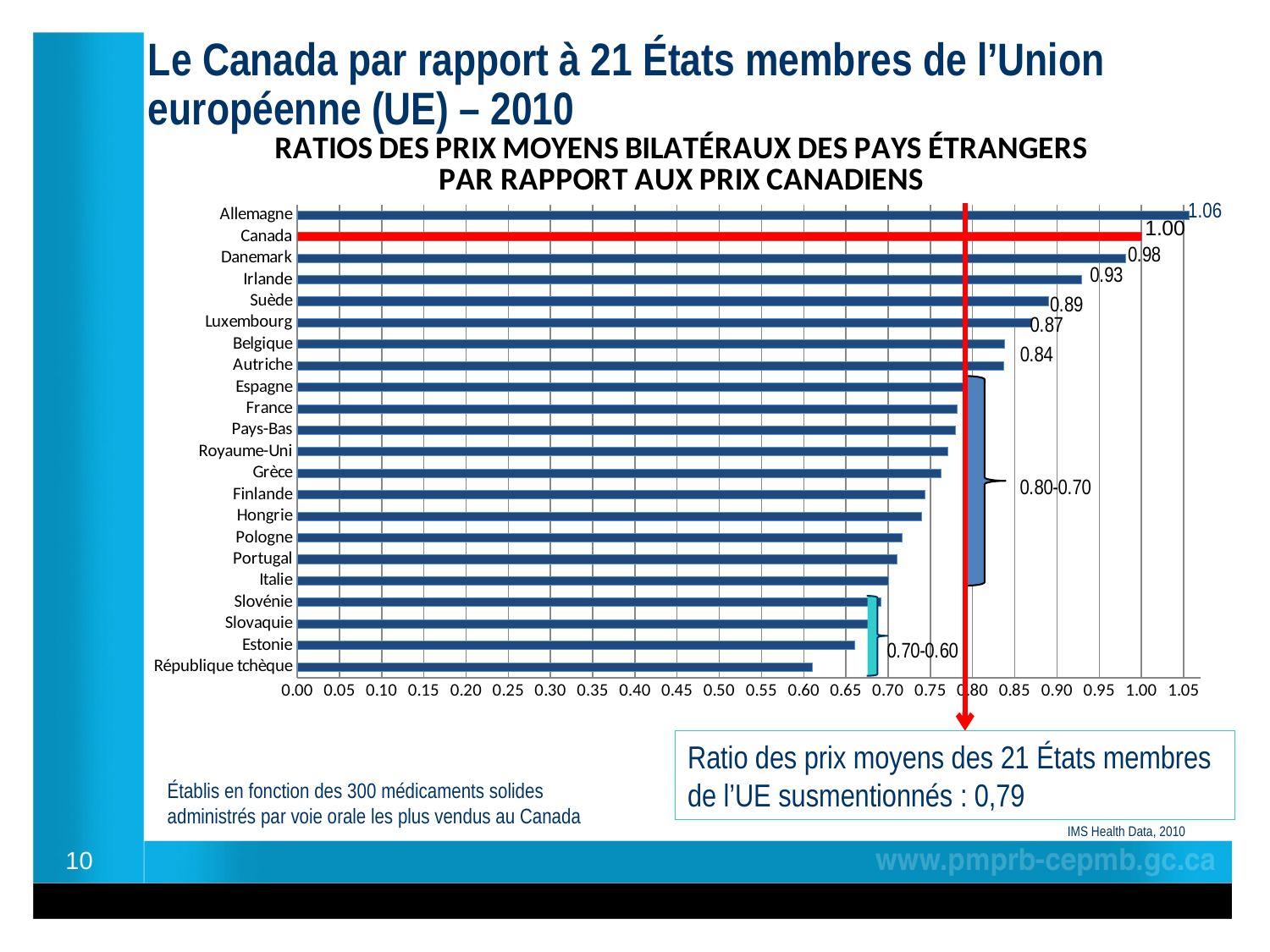
What colour is the bar for Canada? red Which country has the highest ratio on the chart? Allemagne What is the ratio shown for Allemagne? 1.06 What kind of chart is shown on the slide? bar chart Is the value for Hongrie greater or less than 0.70? greater How many countries are listed on the chart? 22 What is the difference between the ratios for Allemagne and Canada? 0.06 What is the ratio shown for Luxembourg? 0.87 What is the ratio shown for Irlande? 0.93 Is the value for République tchèque greater or less than 0.65? less Which country has the lowest ratio on the chart? République tchèque Which has a higher ratio, Suède or Luxembourg? Suède